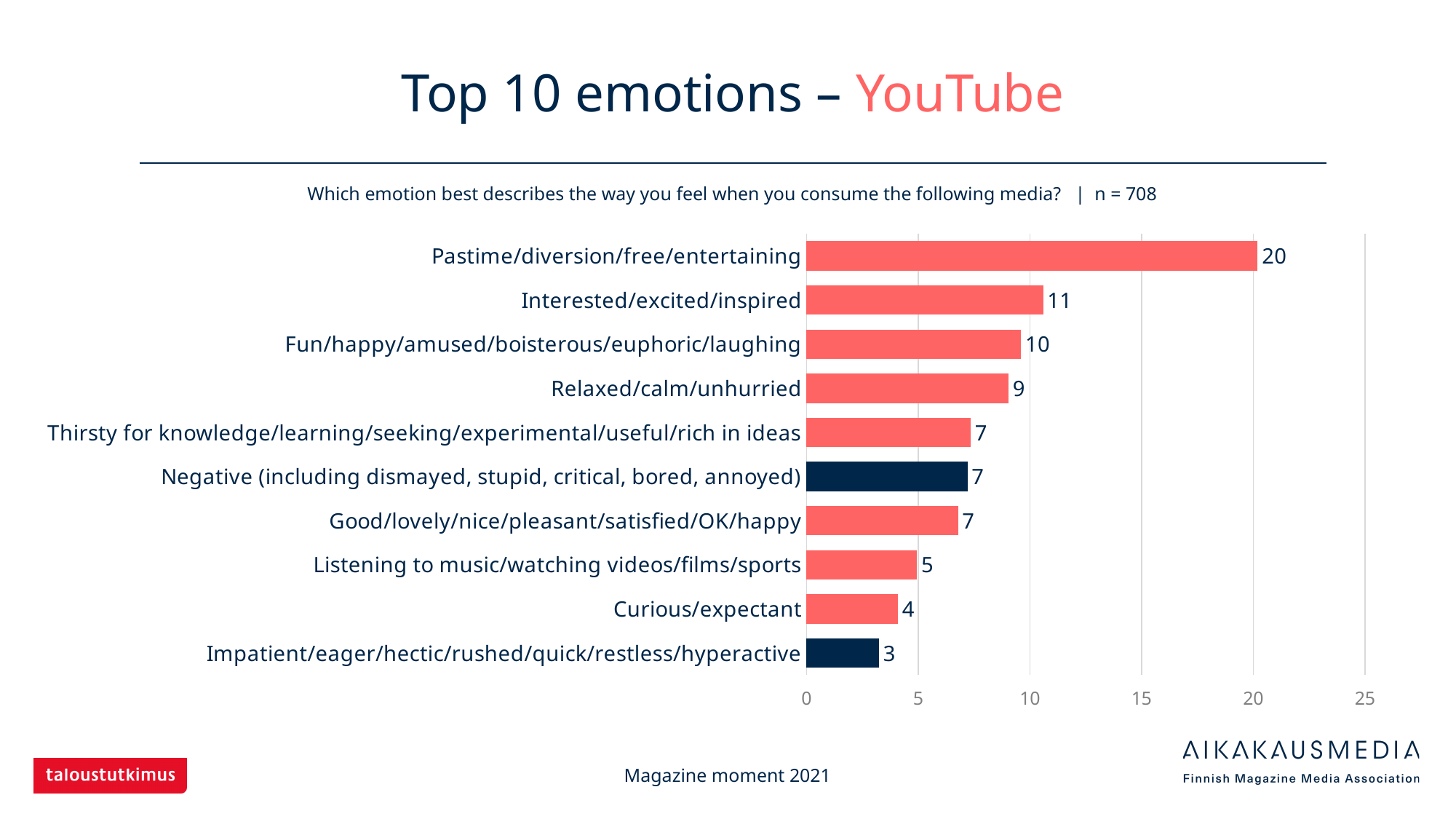
What kind of chart is shown on the slide? Bar chart What is the value for Curious/expectant? 4 Which emotion has the highest value? Pastime/diversion/free/entertaining How many emotion categories are shown in the chart? 10 What is the difference between the values for Pastime/diversion/free/entertaining and Interested/excited/inspired? 9 What is the sample size (n) stated on the slide? 708 What is the value for Negative (including dismayed, stupid, critical, bored, annoyed)? 7 Which is larger, the value for Relaxed/calm/unhurried or the value for Listening to music/watching videos/films/sports? Relaxed/calm/unhurried Which emotion has the lowest value? Impatient/eager/hectic/rushed/quick/restless/hyperactive Is the value for Fun/happy/amused/boisterous/euphoric/laughing greater or less than 5? greater What is the value for Interested/excited/inspired? 11 What is the value for Pastime/diversion/free/entertaining? 20